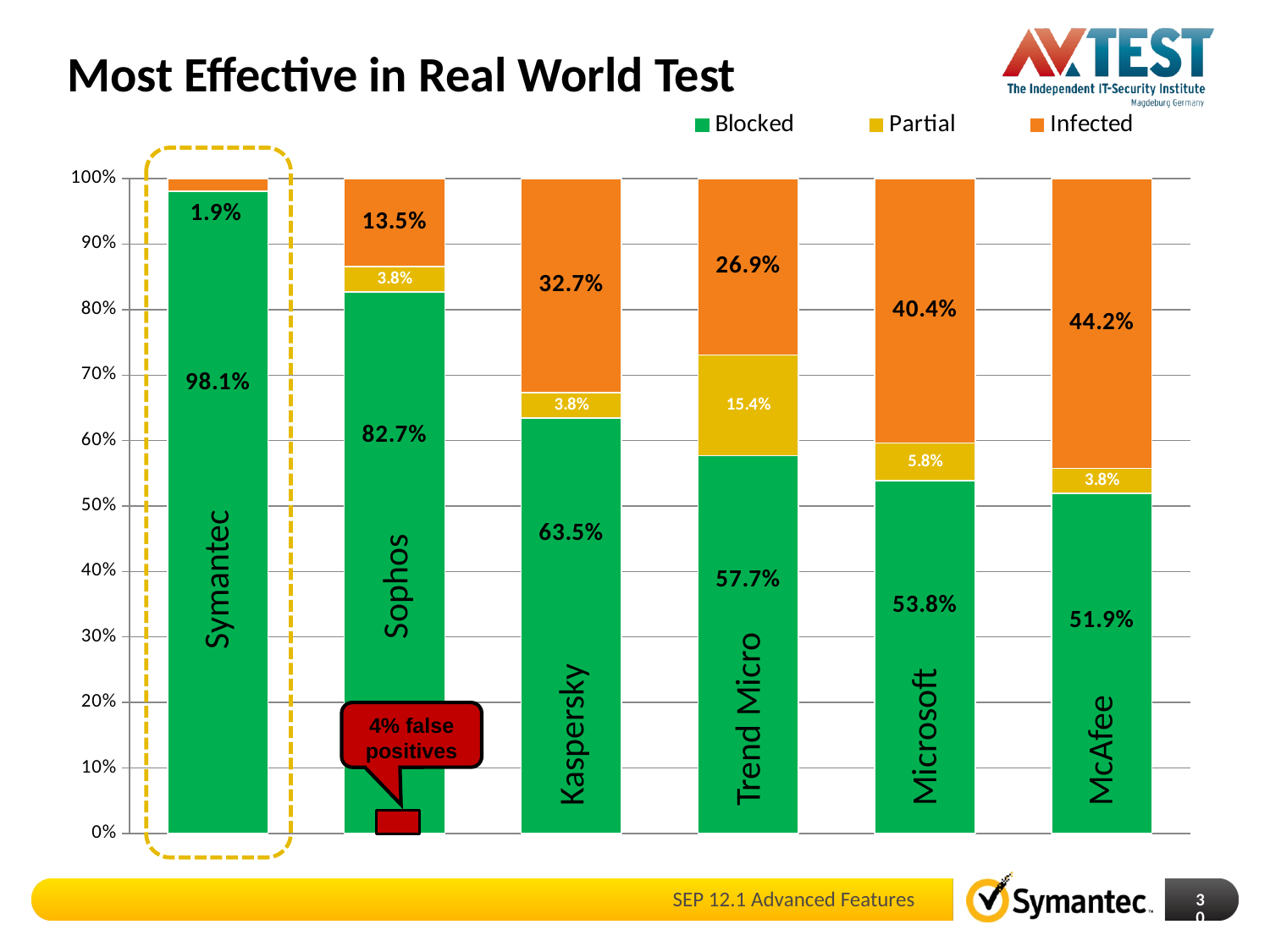
What is the Partial value for Trend Micro? 15.4% Which is larger, the Infected value for Microsoft or the Infected value for Kaspersky? Microsoft What is the Blocked value for Symantec? 98.1% What is the Infected value for McAfee? 44.2% What is the Infected value for Sophos? 13.5% What kind of chart is shown on the slide? Stacked bar chart What is the difference between the Blocked values for Symantec and Sophos? 15.4% How many vendors are shown on the x axis? 6 Which vendor has the lowest Blocked value? McAfee Do the Blocked values rise or fall from Symantec to McAfee along the x axis? Fall How many series does the legend list? 3 Which vendor has the highest Blocked value? Symantec